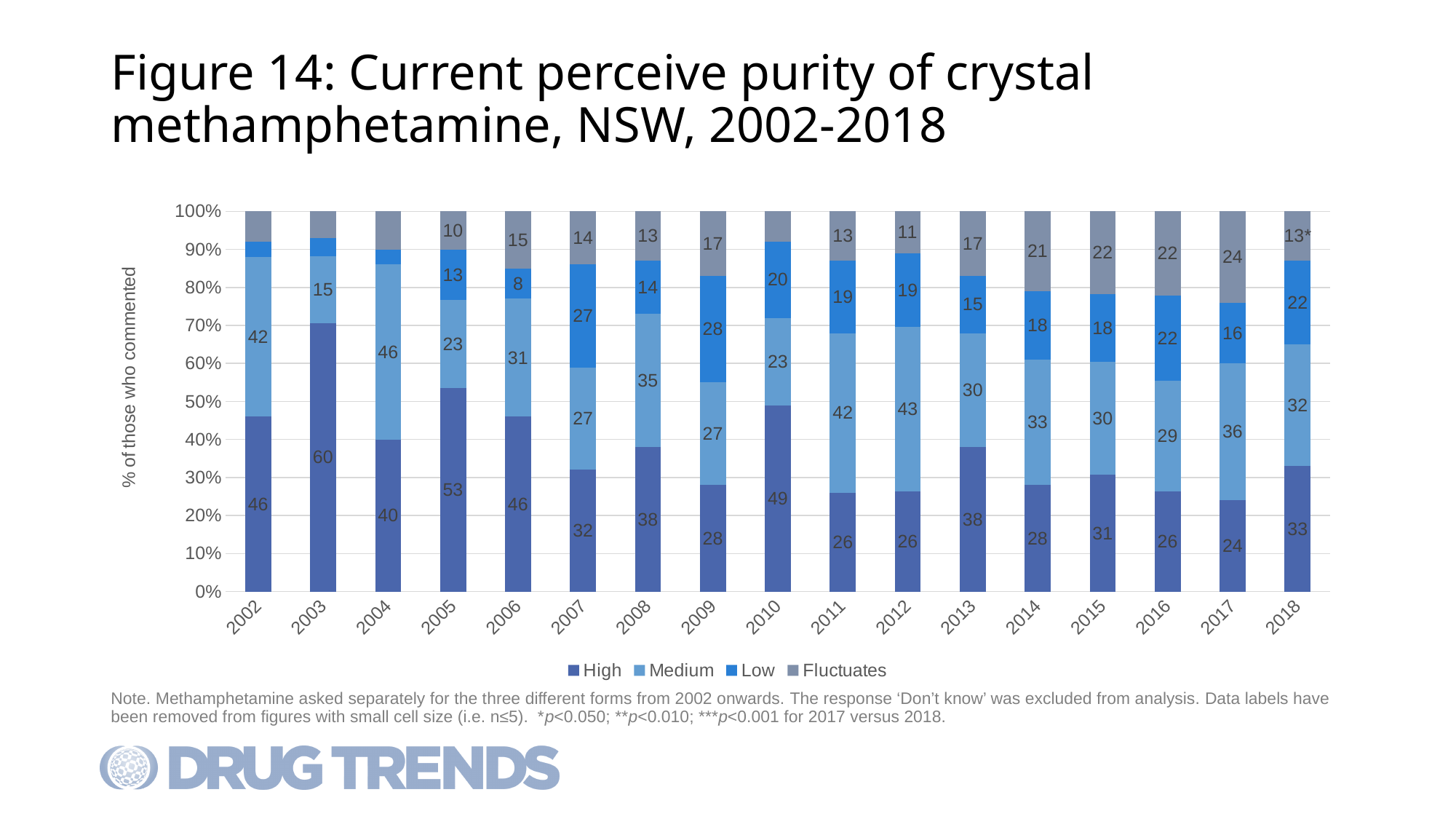
How many series does the legend list? 4 What kind of chart is shown on the slide? Stacked bar chart How many years are shown on the x axis? 17 What percentage of those who commented rated the purity as High in 2003? 60 What is the Low value for 2006? 8 In which year was the High share the smallest? 2017 What is the Medium value for 2012? 43 What is the Fluctuates value for 2017? 24 Is the High value for 2003 greater or less than 50%? greater Which is larger in 2011, the High value or the Medium value? Medium What is the difference between the High values for 2005 and 2007? 21 In which year was the High share the largest? 2003